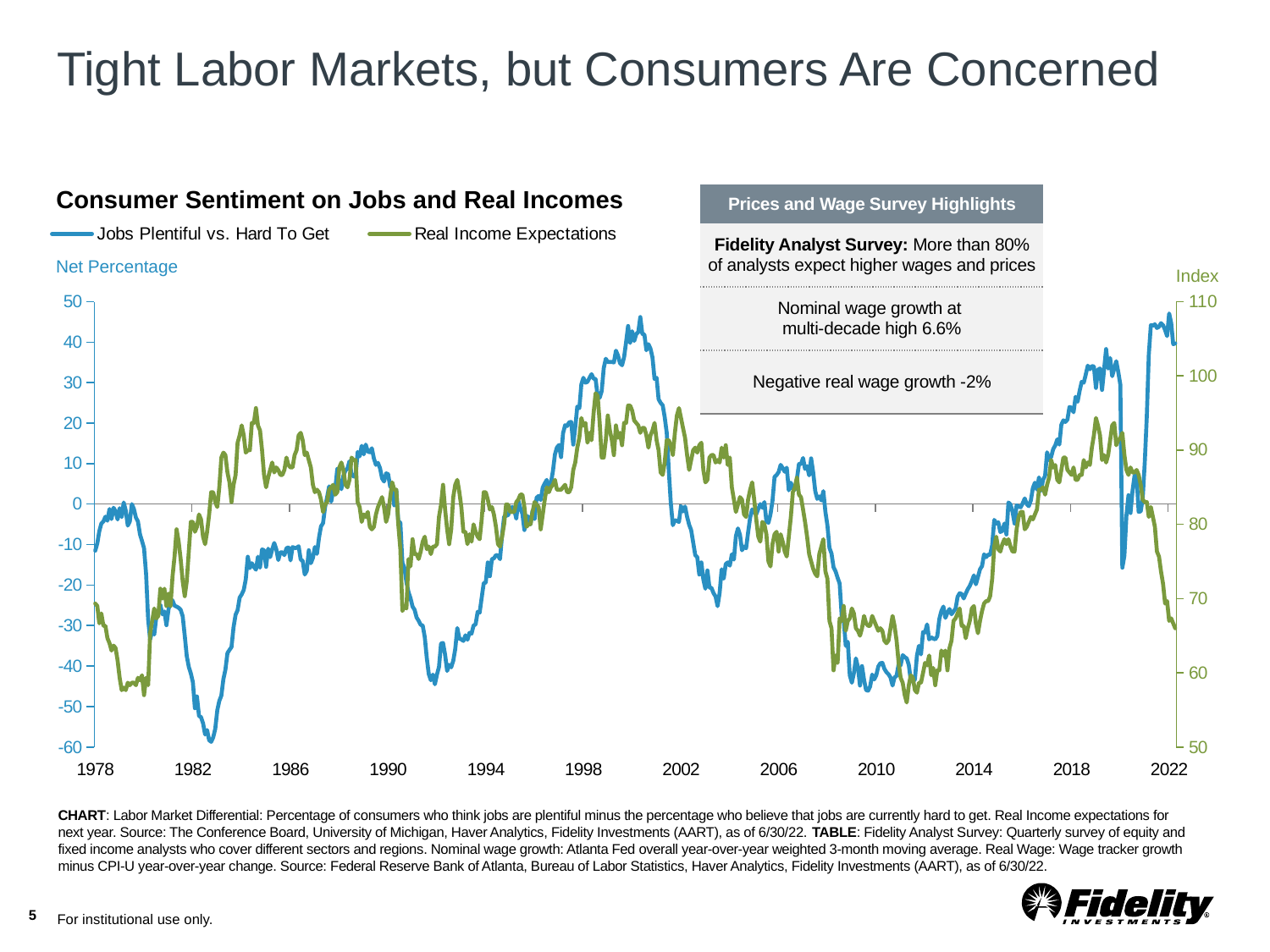
What kind of chart is shown on the slide? Line chart Is the value of Jobs Plentiful vs. Hard To Get around 1982–1983 greater or less than -50? less Does the Real Income Expectations line rise or fall between 2020 and 2022? fall Which series is plotted in green? Real Income Expectations What is the title of the chart? Consumer Sentiment on Jobs and Real Incomes Is the Real Income Expectations index at its peak around 1984 greater or less than 90? greater How many series does the chart legend list? 2 Is the value of Jobs Plentiful vs. Hard To Get at its peak around 2000 greater or less than 40? greater Does the Jobs Plentiful vs. Hard To Get line rise or fall between 2010 and 2019? rise